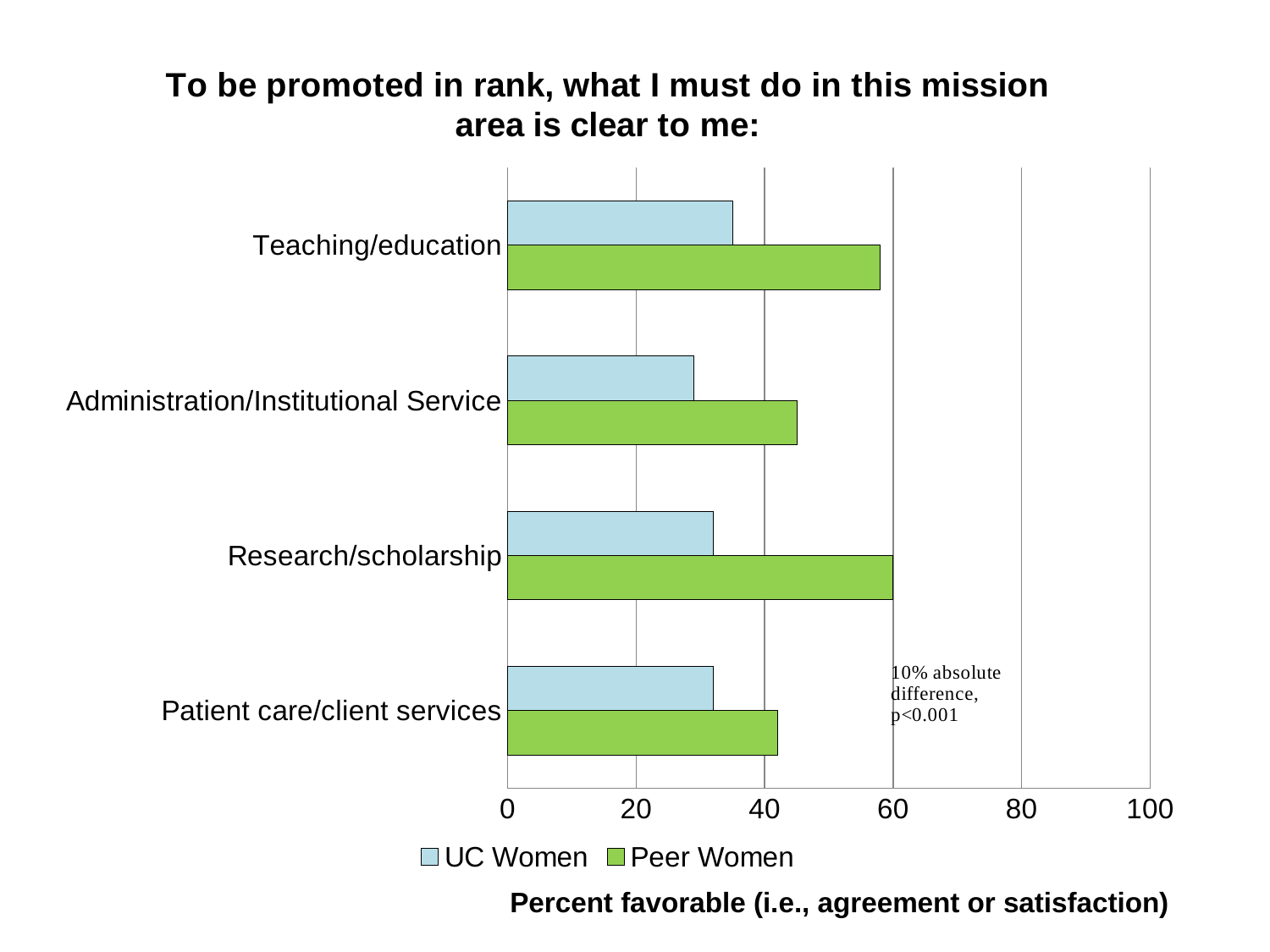
For Teaching/education, which series has the larger value, UC Women or Peer Women? Peer Women What is the label on the horizontal axis of the chart? Percent favorable (i.e., agreement or satisfaction) Which is larger for Peer Women: Teaching/education or Patient care/client services? Teaching/education For Research/scholarship, which series has the larger value, UC Women or Peer Women? Peer Women Is the Peer Women value for Research/scholarship greater or less than 40? greater How many mission-area categories are plotted on the chart? 4 Is the UC Women value for Administration/Institutional Service greater or less than 20? greater What kind of chart is shown on the slide? bar chart Which category has the highest value for UC Women? Teaching/education Is the UC Women value for Teaching/education greater or less than 40? less How many series does the legend list? 2